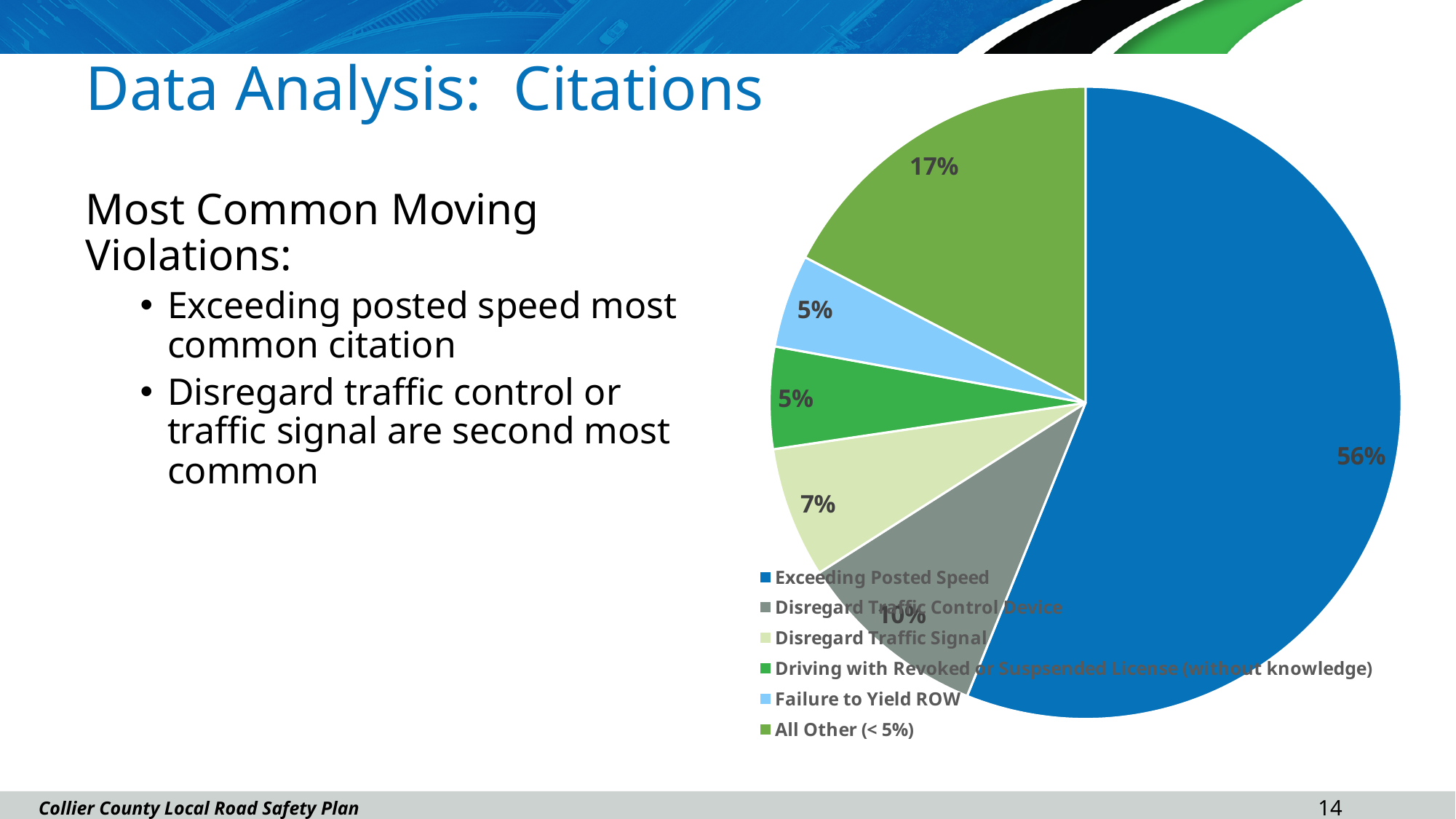
How many slices does the pie chart have? 6 Which is larger: Disregard Traffic Control Device or Disregard Traffic Signal? Disregard Traffic Control Device What colour is the slice for Exceeding Posted Speed? blue What kind of chart is shown on the slide? pie chart What share of citations is All Other (< 5%)? 17% Which category has the largest slice of the pie? Exceeding Posted Speed What share of citations is Disregard Traffic Signal? 7% What share of citations is Disregard Traffic Control Device? 10% What is the combined share of Disregard Traffic Control Device and Disregard Traffic Signal? 17% What is the difference in percentage points between Exceeding Posted Speed and All Other (< 5%)? 39